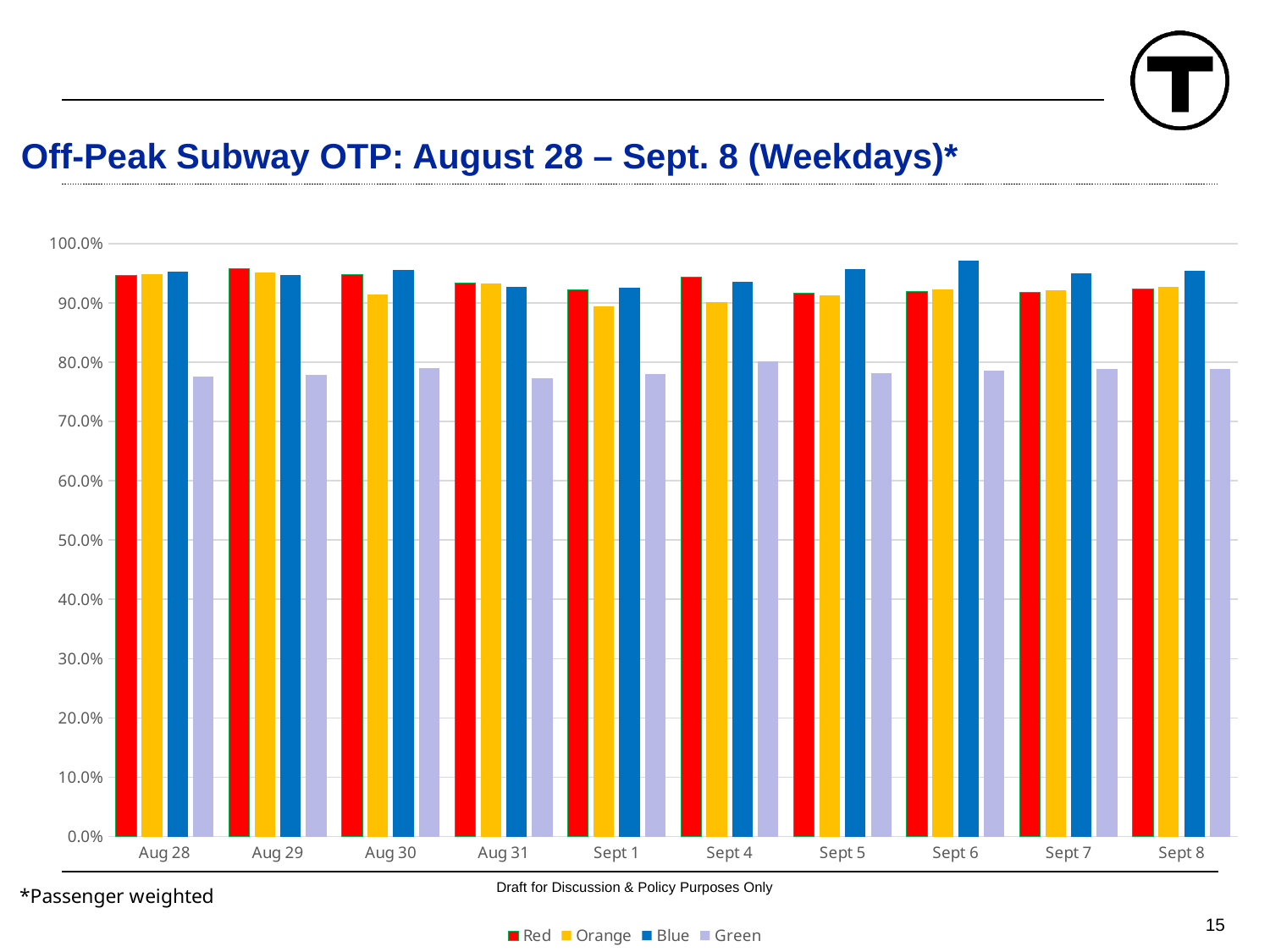
How many dates are shown along the x axis of the chart? 10 Which series has the lowest value on every date shown in the chart? Green What kind of chart is shown on the slide? Bar chart On Sept 5, which is larger, the Blue value or the Red value? Blue Is the value for Orange on Aug 30 greater or less than 90.0%? greater How many series does the chart's legend list? 4 Is the value for Blue on Sept 6 greater or less than 90.0%? greater Which series has the highest bar on Sept 6? Blue What are the four series listed in the chart's legend? Red, Orange, Blue, Green Is the value for Green on Aug 28 greater or less than 80.0%? less On Aug 30, which is larger, the Red value or the Orange value? Red What is the title of the chart on the slide? Off-Peak Subway OTP: August 28 – Sept. 8 (Weekdays)*